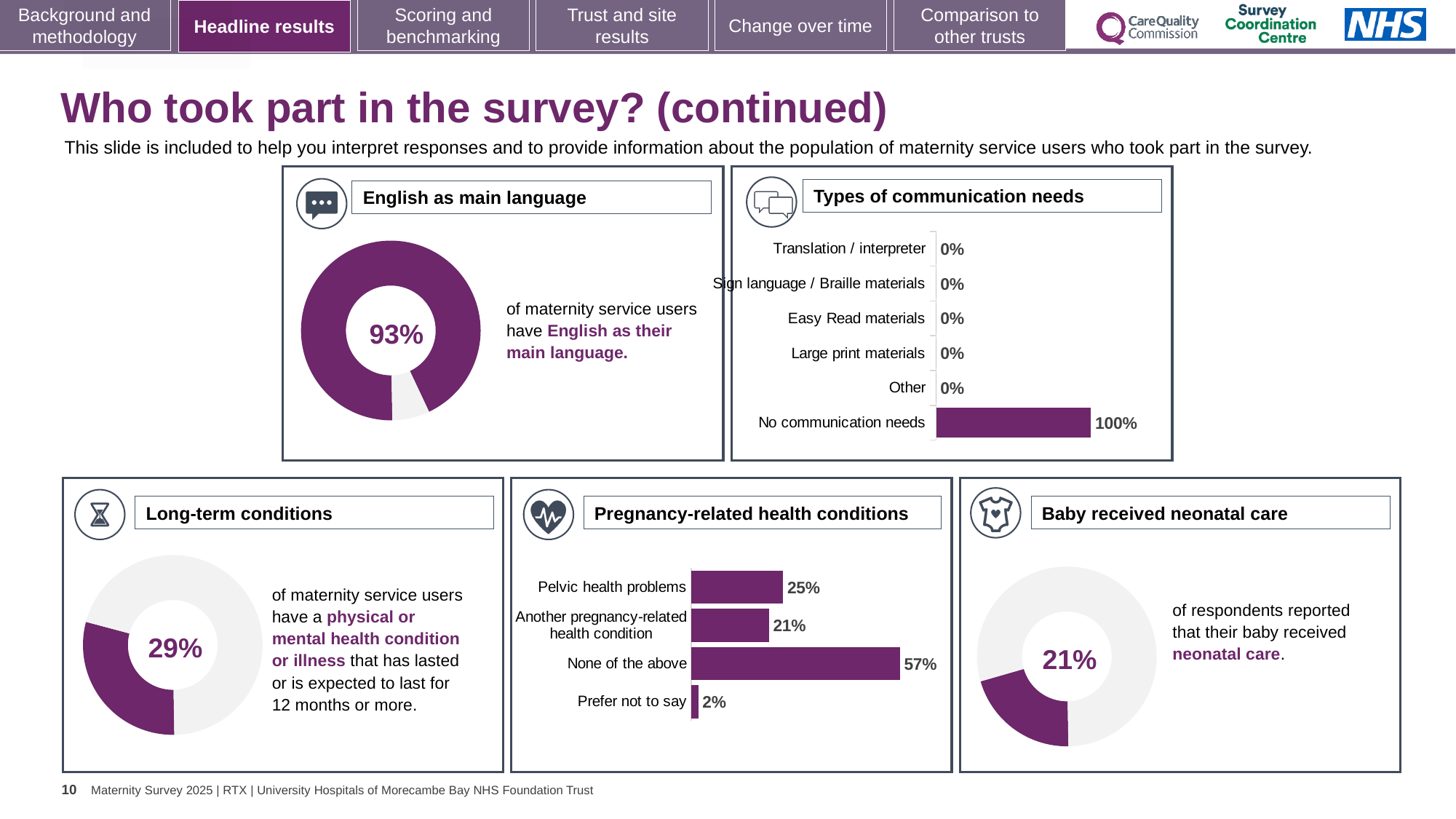
In the 'Baby received neonatal care' chart, what percentage of respondents reported that their baby received neonatal care? 21% In the 'Types of communication needs' chart, which category has the highest value? No communication needs In the 'English as main language' chart, what percentage of maternity service users have English as their main language? 93% In the 'Long-term conditions' chart, what percentage of maternity service users have a physical or mental health condition or illness? 29% In the 'Pregnancy-related health conditions' chart, what is the value for 'Pelvic health problems'? 25% In the 'Pregnancy-related health conditions' chart, which category has the highest value? None of the above In the 'Types of communication needs' chart, what is the value for 'Translation / interpreter'? 0% In the 'Pregnancy-related health conditions' chart, which category has the lowest value? Prefer not to say What kind of chart is used for 'Pregnancy-related health conditions'? Bar chart In the 'Types of communication needs' chart, how many categories are shown? 6 In the 'Pregnancy-related health conditions' chart, what is the difference between 'None of the above' and 'Another pregnancy-related health condition'? 36% In the 'Types of communication needs' chart, what is the value for 'No communication needs'? 100%